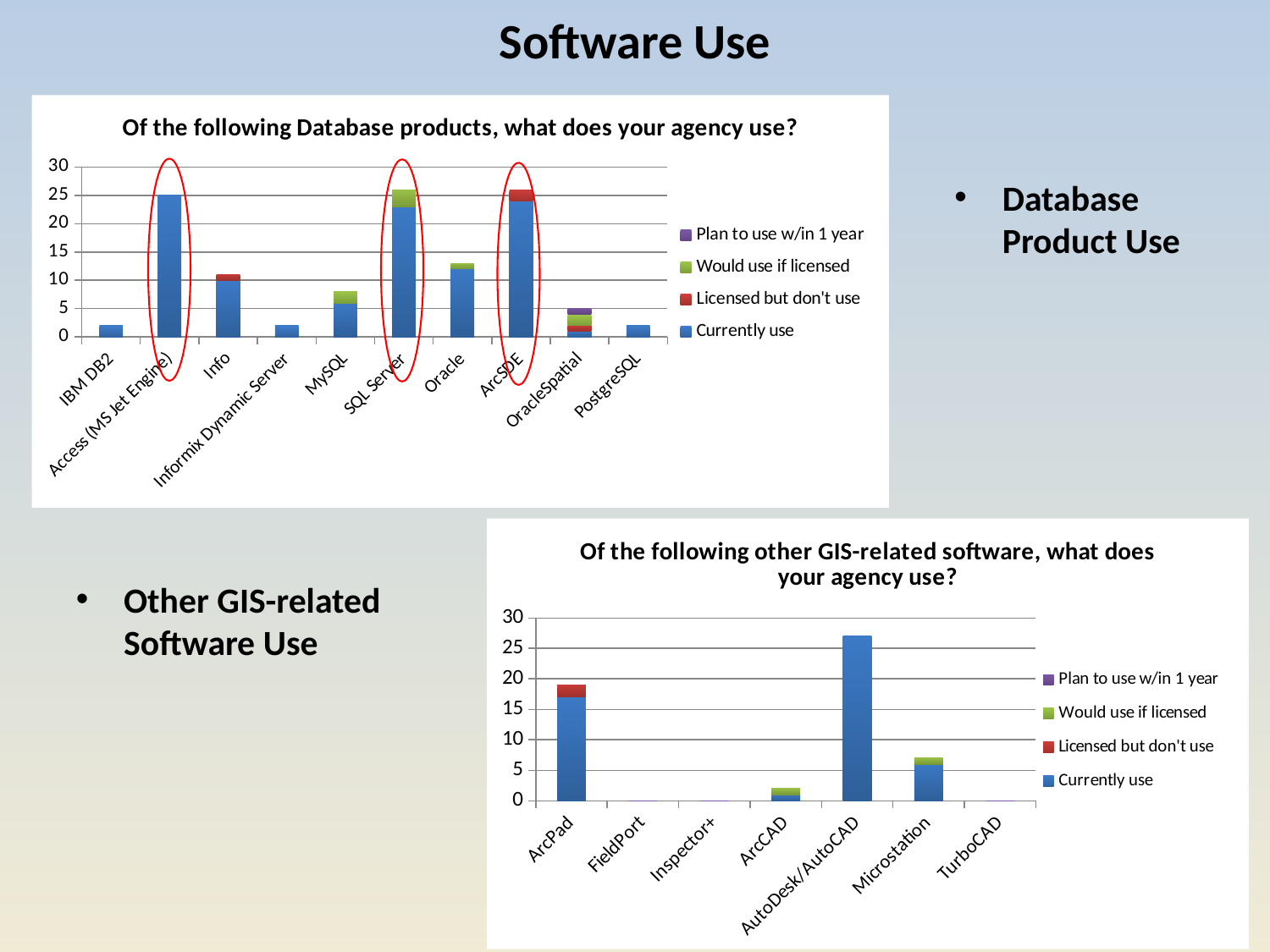
In the chart titled "Of the following Database products, what does your agency use?", which series is shown in blue? Currently use What kind of chart is the one titled "Of the following other GIS-related software, what does your agency use?"? bar chart In the chart titled "Of the following other GIS-related software, what does your agency use?", is the value for AutoDesk/AutoCAD greater or less than 25? greater In the chart titled "Of the following Database products, what does your agency use?", is the total value for Access (MS Jet Engine) greater or less than 20? greater In the chart titled "Of the following Database products, what does your agency use?", is the value for IBM DB2 greater or less than 5? less In the chart titled "Of the following Database products, what does your agency use?", how many series does the legend list? 4 In the chart titled "Of the following other GIS-related software, what does your agency use?", how many software products are listed on the x axis? 7 In the chart titled "Of the following Database products, what does your agency use?", how many database products are listed on the x axis? 10 In the chart titled "Of the following other GIS-related software, what does your agency use?", which has the larger total bar, ArcPad or Microstation? ArcPad In the chart titled "Of the following other GIS-related software, what does your agency use?", which software has the highest bar? AutoDesk/AutoCAD In the chart titled "Of the following Database products, what does your agency use?", which has the larger total bar, Access (MS Jet Engine) or Info? Access (MS Jet Engine)